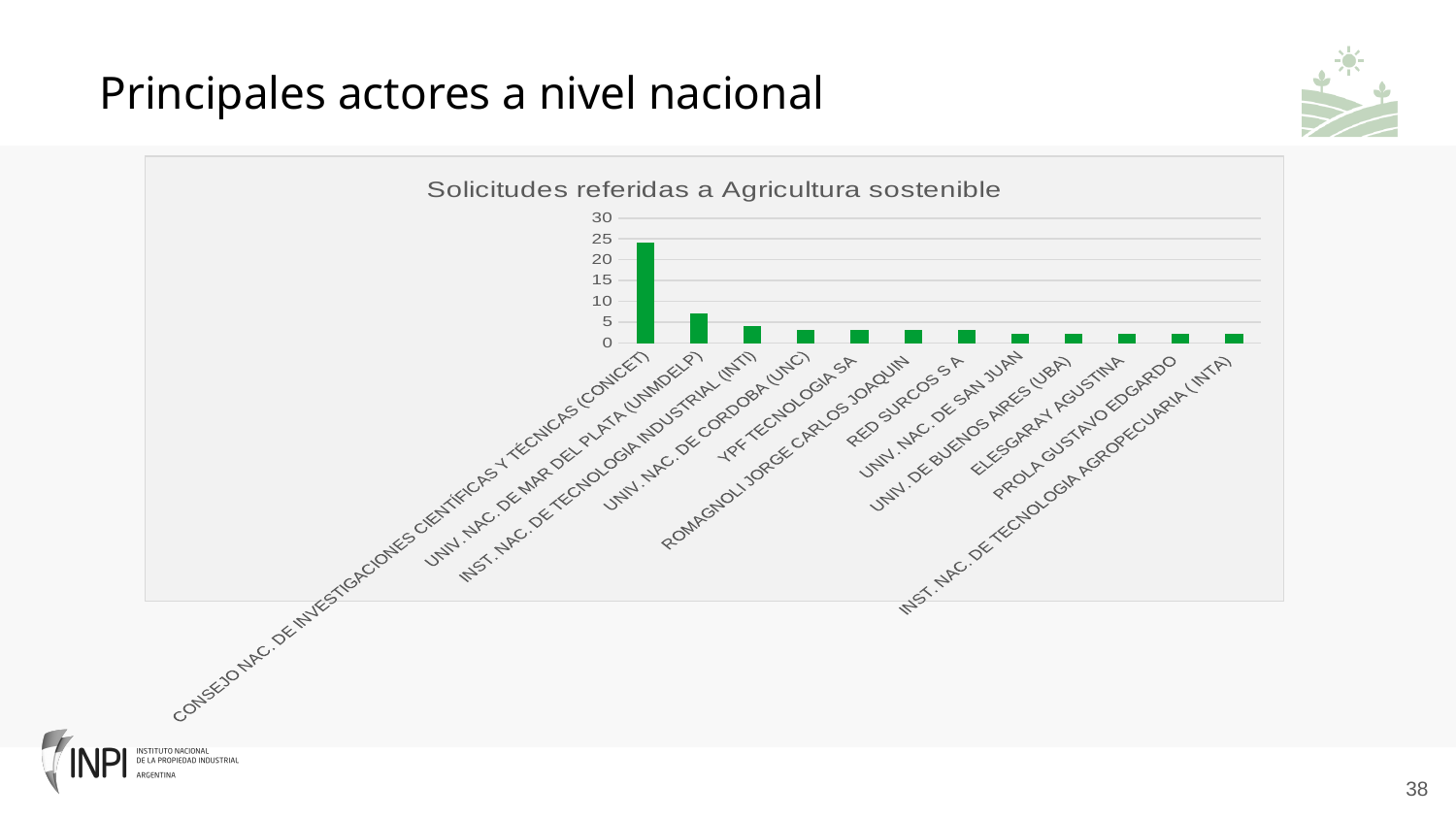
Is the value for YPF TECNOLOGIA SA greater or less than 5? less Is the value for UNIV. NAC. DE MAR DEL PLATA (UNMDELP) greater or less than 10? less How many categories (actors) are plotted in the chart? 12 What is the title of the chart? Solicitudes referidas a Agricultura sostenible Is the value for CONSEJO NAC. DE INVESTIGACIONES CIENTÍFICAS Y TÉCNICAS (CONICET) greater or less than 20? greater Which actor has the highest number of solicitudes? CONSEJO NAC. DE INVESTIGACIONES CIENTÍFICAS Y TÉCNICAS (CONICET) What kind of chart is shown on the slide? bar chart Do the values rise or fall from left to right along the x axis? fall Which is larger, the value for UNIV. NAC. DE MAR DEL PLATA (UNMDELP) or the value for RED SURCOS S A? UNIV. NAC. DE MAR DEL PLATA (UNMDELP) Which is larger, the value for CONSEJO NAC. DE INVESTIGACIONES CIENTÍFICAS Y TÉCNICAS (CONICET) or the value for UNIV. NAC. DE MAR DEL PLATA (UNMDELP)? CONSEJO NAC. DE INVESTIGACIONES CIENTÍFICAS Y TÉCNICAS (CONICET)